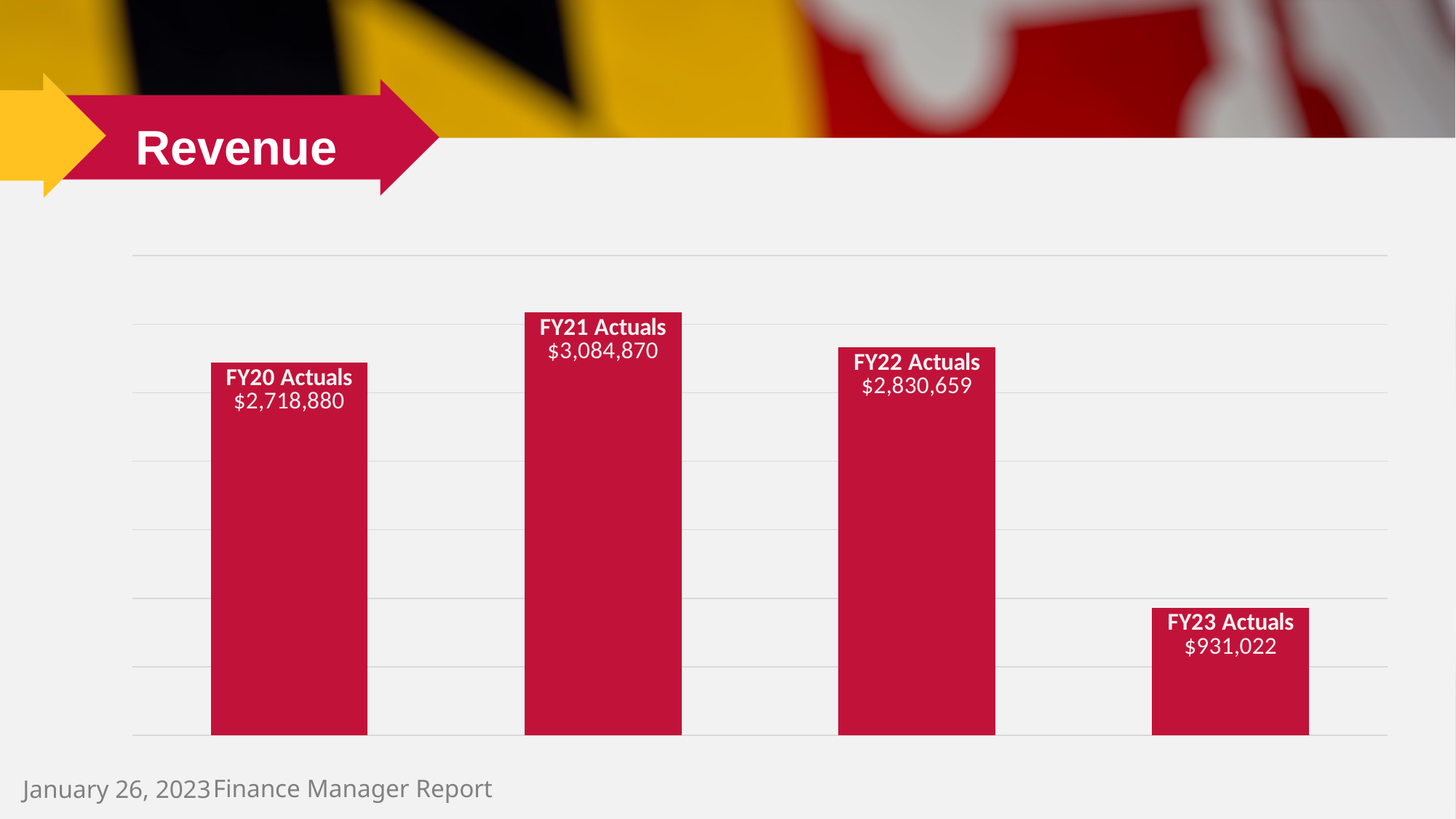
What kind of chart is shown on the slide? Bar chart What is the difference between FY22 Actuals and FY23 Actuals? $1,899,637 What is the value for FY23 Actuals? $931,022 What is the value for FY22 Actuals? $2,830,659 What is the value for FY21 Actuals? $3,084,870 Which fiscal year has the highest revenue? FY21 Actuals What is the difference between FY21 Actuals and FY20 Actuals? $365,990 Which fiscal year has the lowest revenue? FY23 Actuals Which is larger, FY20 Actuals or FY22 Actuals? FY22 Actuals What is the value for FY20 Actuals? $2,718,880 How many bars are shown in the chart? 4 Does revenue rise or fall from FY22 Actuals to FY23 Actuals? Fall